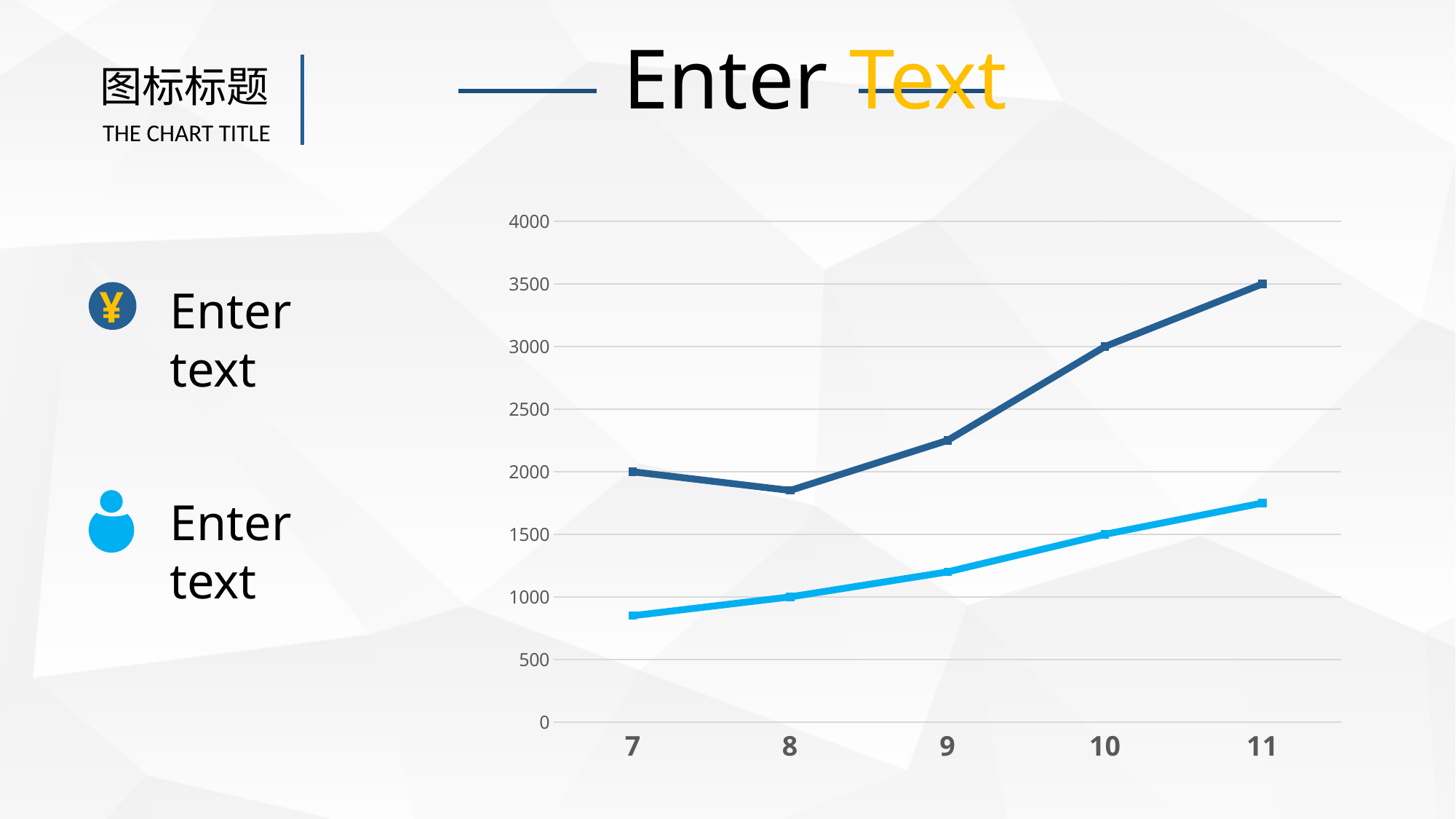
What is the value of the light blue line at x = 10? 1500 How many lines are plotted on the chart? 2 What is the value of the light blue line at x = 8? 1000 Does the light blue line rise or fall from x = 7 to x = 11? rise Is the value of the light blue line at x = 7 greater or less than 1000? less Is the value of the dark blue line at x = 8 greater or less than 2000? less At which x value does the dark blue line reach its highest point? 11 What is the value of the dark blue line at x = 7? 2000 What kind of chart is shown on the slide? line chart What is the value of the dark blue line at x = 11? 3500 What is the value of the dark blue line at x = 10? 3000 How many points are plotted along the x axis for each line? 5